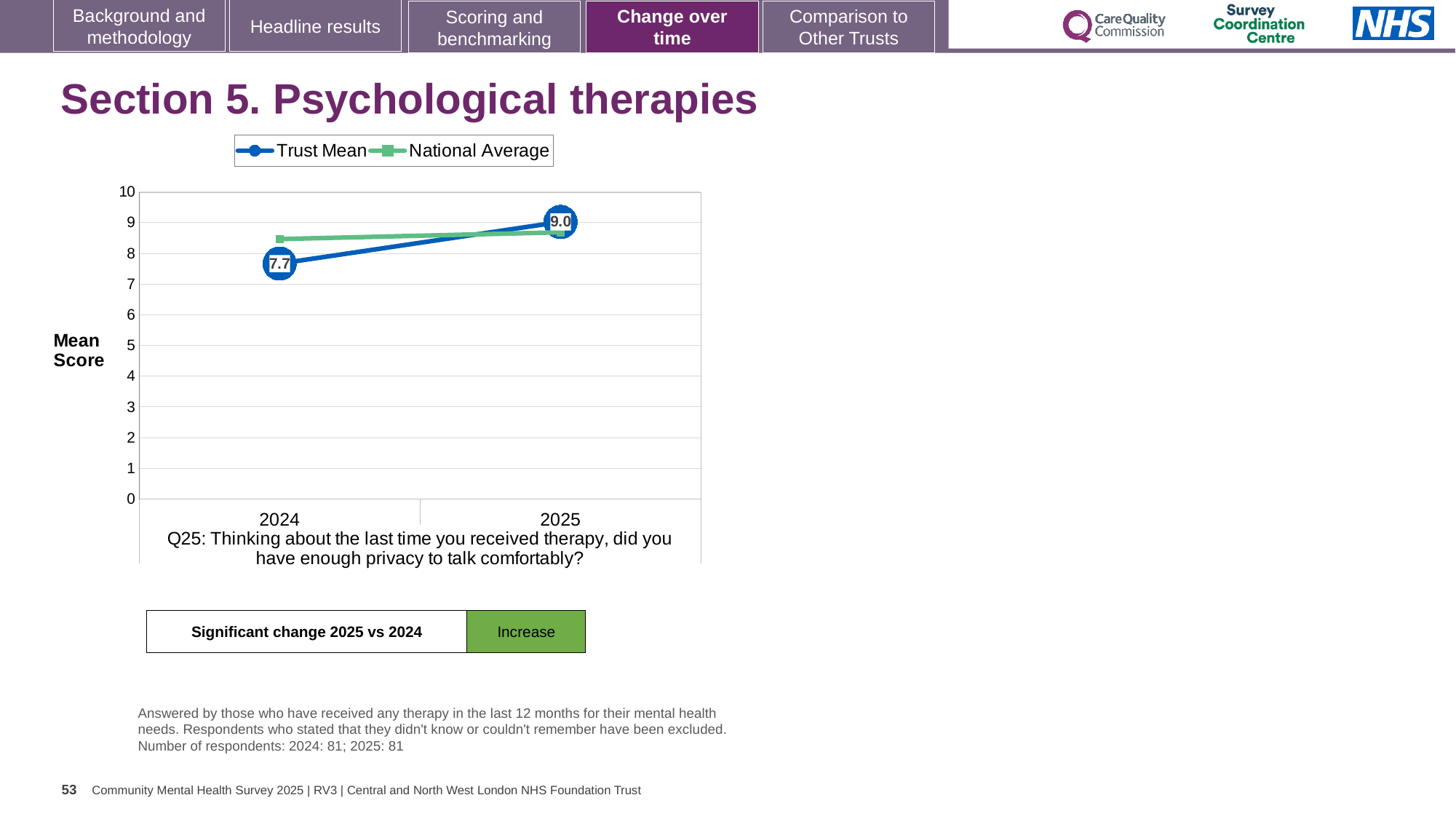
In 2024, which is higher: the Trust Mean or the National Average? National Average How many years are shown on the x axis? 2 How many series does the legend list? 2 Does the Trust Mean rise or fall from 2024 to 2025? rise Is the National Average for 2024 greater or less than 8? greater What kind of chart is shown on the slide? line chart By how much did the Trust Mean score change from 2024 to 2025? 1.3 Is the National Average for 2025 greater or less than 9? less What is the Trust Mean score for 2024? 7.7 In which year is the Trust Mean score higher? 2025 In which year is the Trust Mean score lower? 2024 What is the Trust Mean score for 2025? 9.0